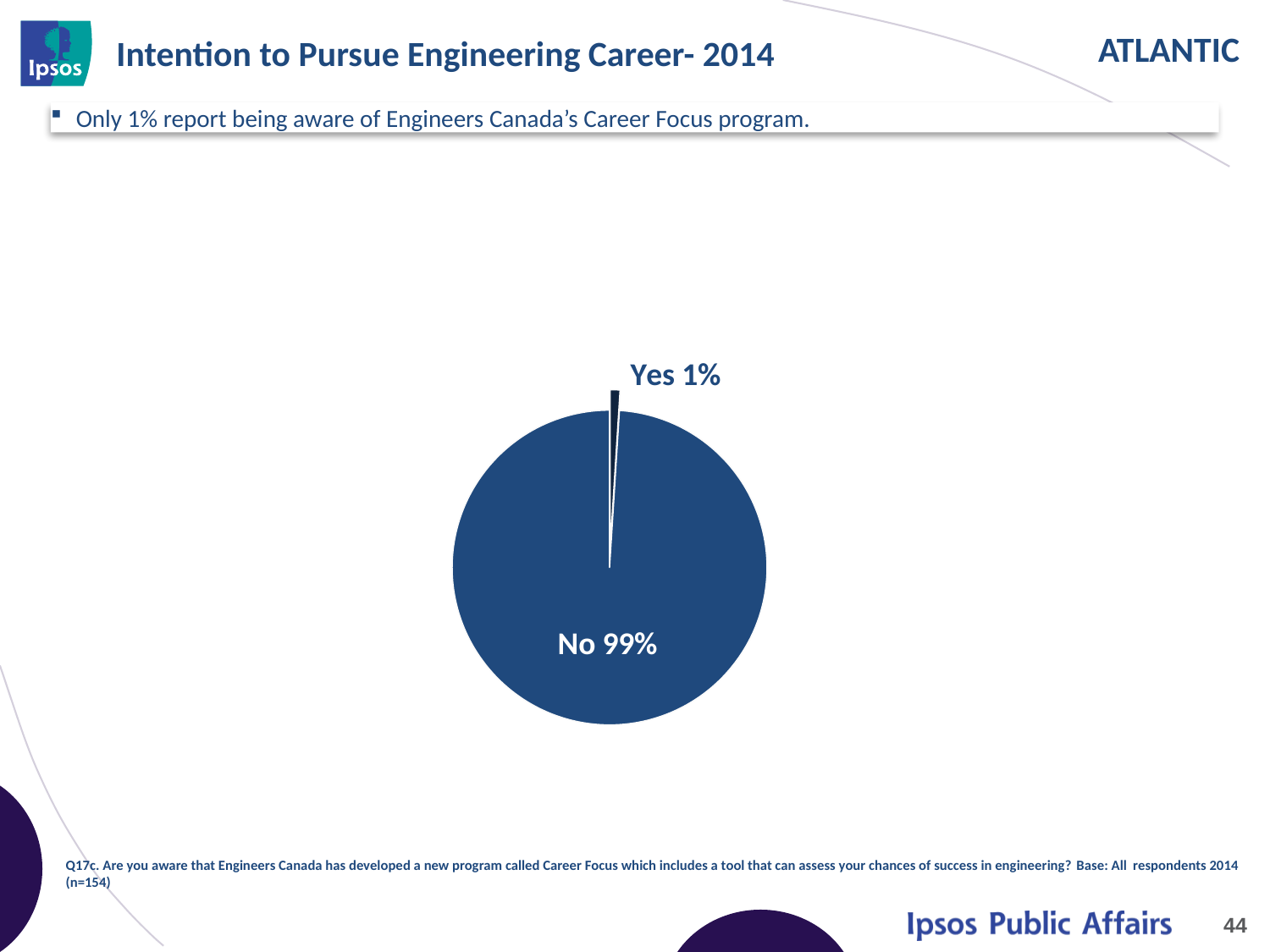
What is the total of the two slices shown in the pie chart? 100% Which is larger, the "Yes" slice or the "No" slice? No What kind of chart is shown on the slide? pie chart Which slice of the pie is the smallest? Yes How many slices does the pie chart have? 2 What percentage of respondents answered "No"? 99% Which slice of the pie is the largest? No What is the difference in percentage points between the "No" and "Yes" slices? 98 What percentage of respondents answered "Yes"? 1% What is the title of the slide containing the pie chart? Intention to Pursue Engineering Career- 2014 What is the base size (n) noted for the 2014 respondents in the chart's footnote? n=154 What share of the pie does the "No" slice represent? 99%